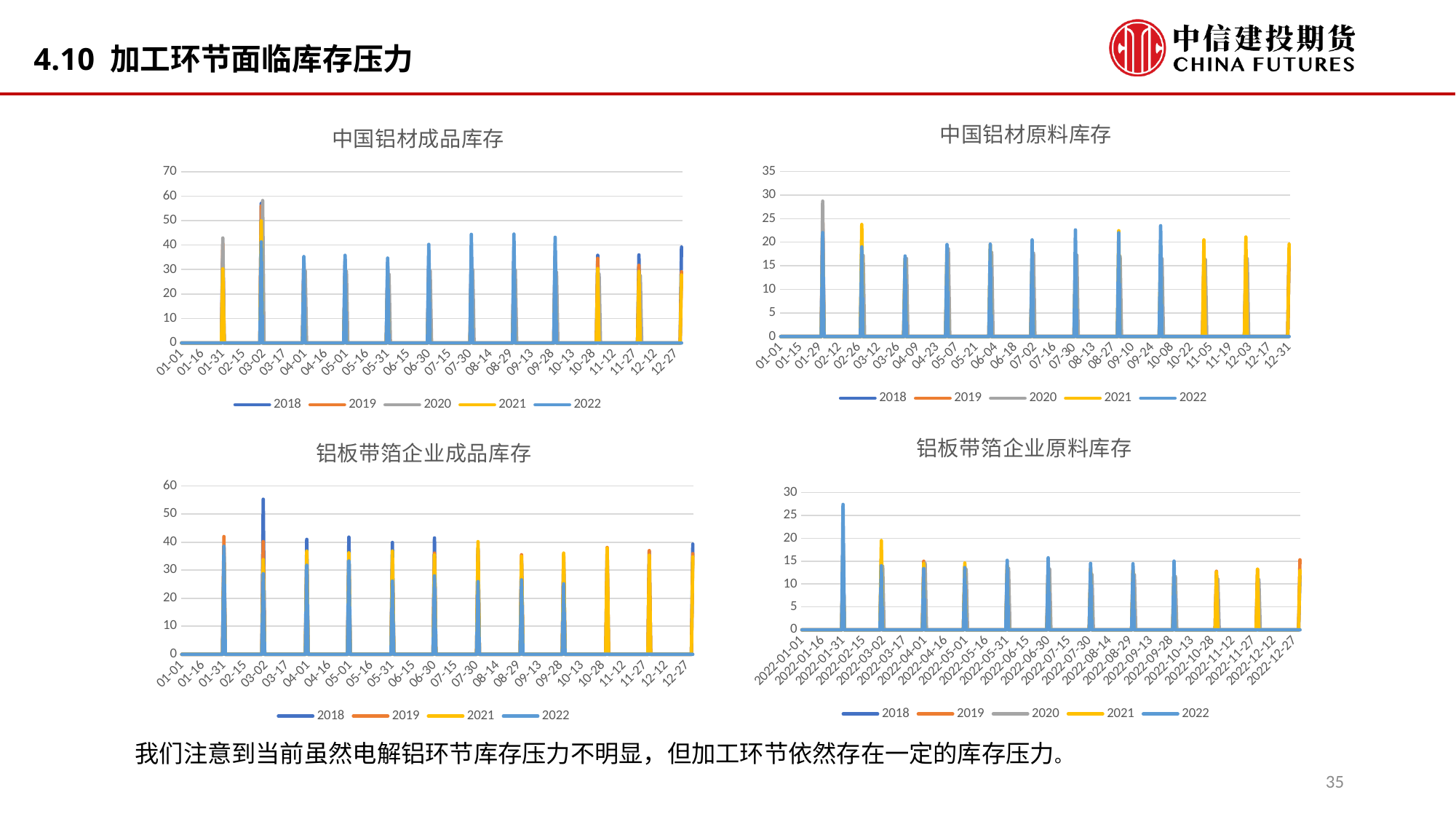
What is the highest value shown on the vertical axis of the top-left chart (中国铝材成品库存)? 70 In the bottom-left chart (铝板带箔企业成品库存), is the highest peak near 03-02 greater or less than 50? greater In the bottom-right chart (铝板带箔企业原料库存), is the peak near 2022-01-31 greater or less than 25? greater In the top-left chart (中国铝材成品库存), is the highest peak near 03-02 greater or less than 50? greater Which year is missing from the legend of the bottom-left chart (铝板带箔企业成品库存) compared with the other three charts? 2020 What type of chart is the top-left chart titled 中国铝材成品库存? line chart How many series does the legend of the top-left chart (中国铝材成品库存) list? 5 What is the highest value shown on the vertical axis of the top-right chart (中国铝材原料库存)? 35 How many series does the legend of the bottom-left chart (铝板带箔企业成品库存) list? 4 How many charts are shown on the slide? 4